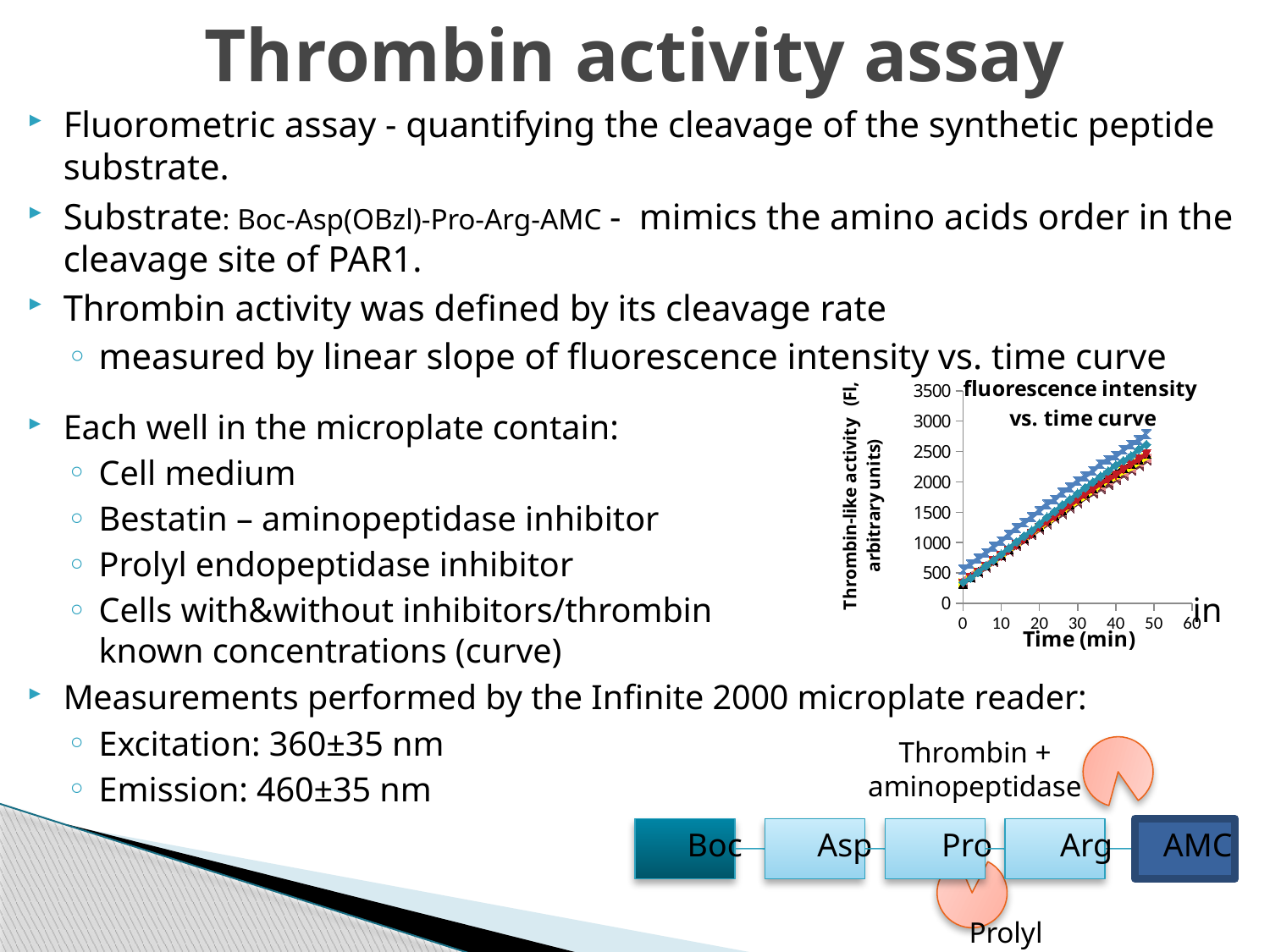
What is the title of the chart on the slide? fluorescence intensity vs. time curve What is the label of the x axis of the chart? Time (min) Is the value of the topmost series at 40 minutes greater or less than 2000? greater Is the value of the topmost series at 20 minutes greater or less than 1000? greater What kind of chart is shown on the slide? line chart Is the value of the lowest series at 30 minutes greater or less than 2000? less Do the plotted values rise or fall as time increases along the x axis? rise